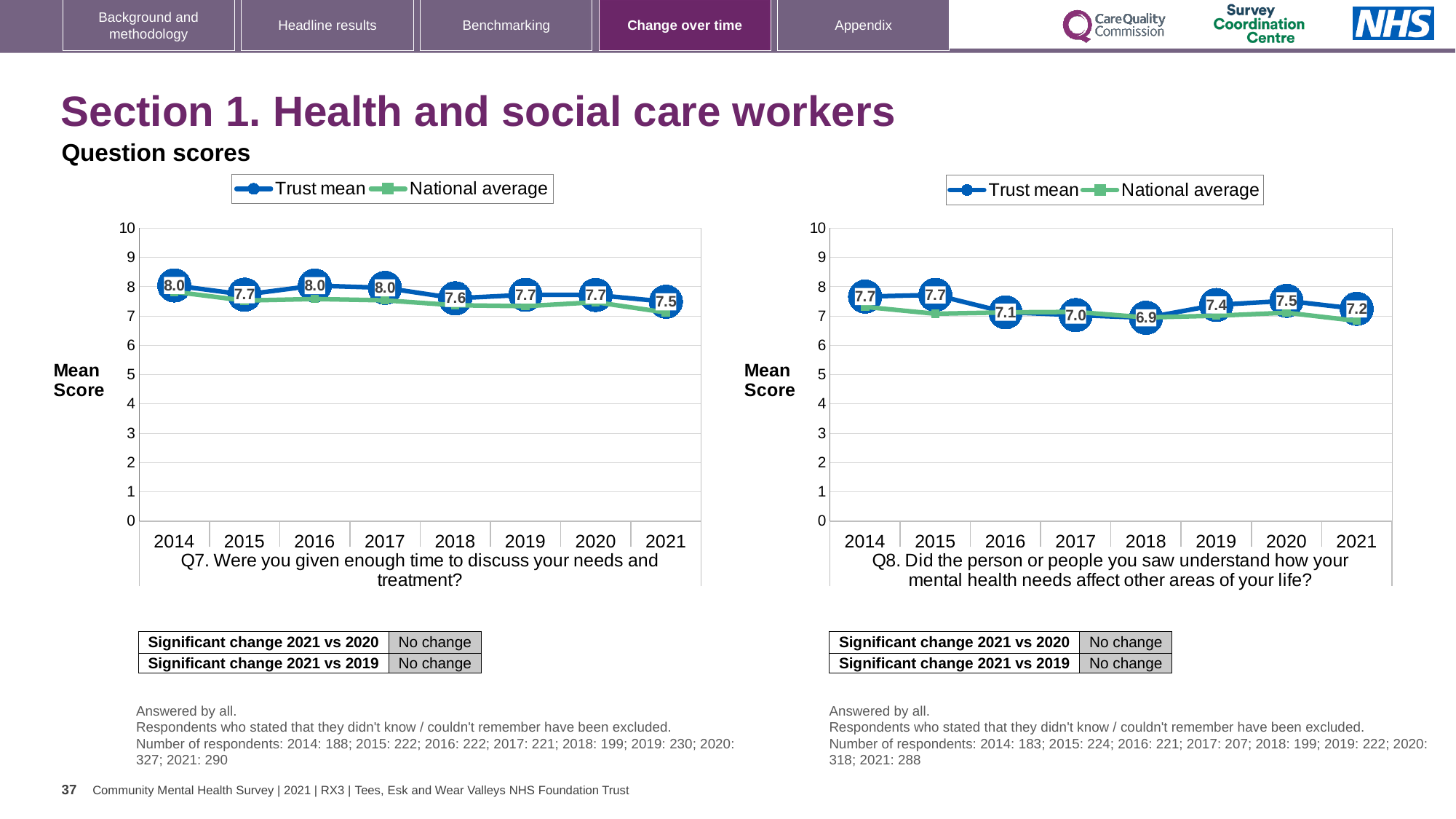
In the Q8 chart (right), what is the difference between the Trust mean scores for 2015 and 2018? 0.8 In the Q7 chart (left), what is the Trust mean score for 2021? 7.5 In the Q8 chart (right), what is the Trust mean score for 2020? 7.5 In the Q7 chart (left), what is the Trust mean score for 2018? 7.6 What kind of chart is the Q7 chart (left)? Line chart In the Q7 chart (left), which year has the lowest Trust mean score? 2021 In the Q8 chart (right), is the National average for 2018 greater or less than 8? less How many years are shown on the x axis of the Q7 chart (left)? 8 In the Q8 chart (right), which year has the lowest Trust mean score? 2018 In the Q8 chart (right), what is the Trust mean score for 2018? 6.9 How many series does the legend of the Q8 chart (right) list? 2 In the Q7 chart (left), which is larger, the Trust mean score for 2016 or for 2021? 2016